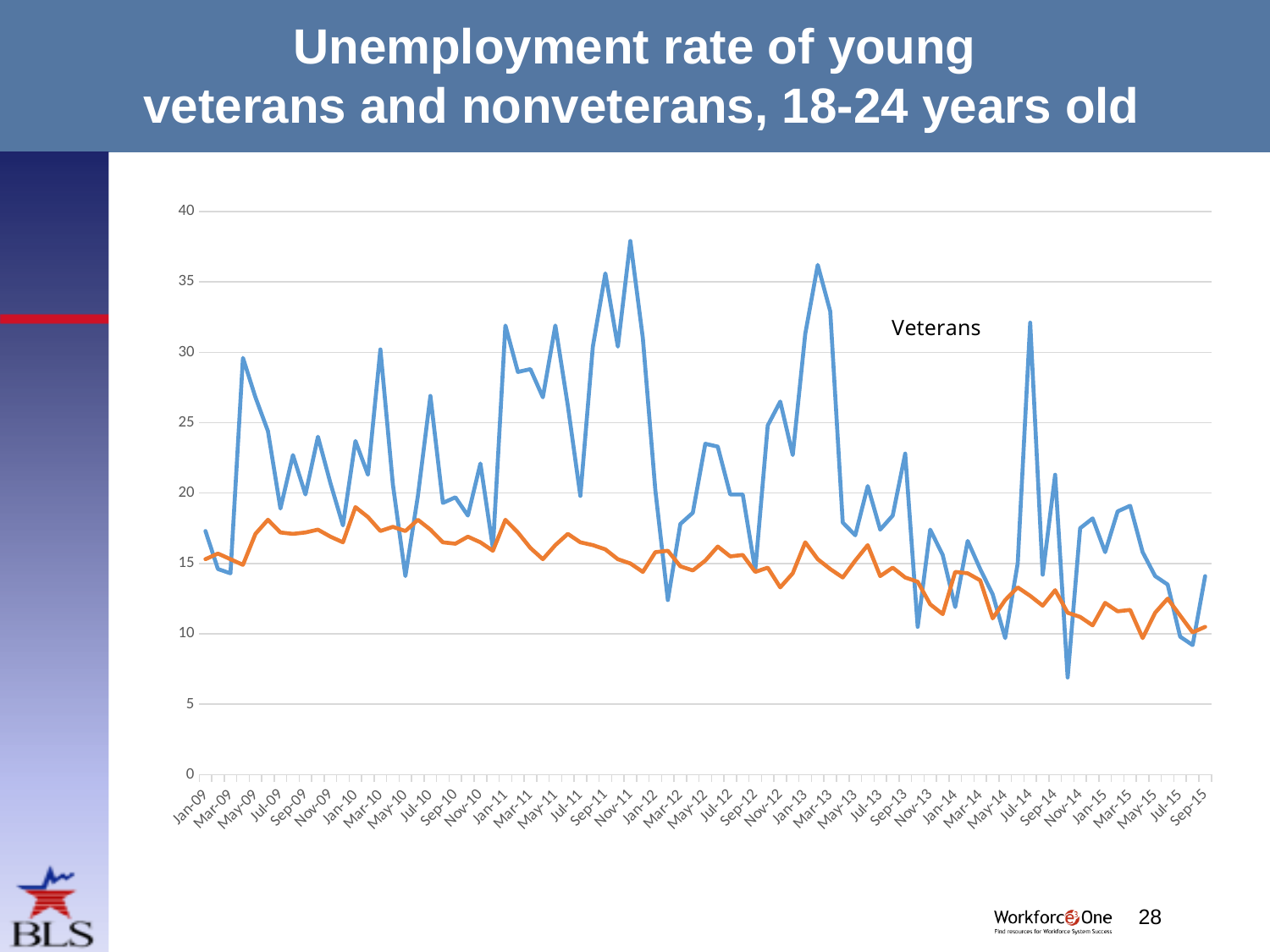
What is the highest value shown on the vertical axis? 40 Which series is labelled directly on the chart? Veterans Does the orange (nonveterans) line ever rise above 20? No Does the orange (nonveterans) line generally rise or fall from Jan-09 to Sep-15? fall Is the lowest value of the Veterans line (around Nov-14) greater or less than 10? less How many lines (series) are plotted on the chart? 2 What kind of chart is shown on the slide? line chart Around which month does the Veterans line reach its highest peak? Nov-11 Is the highest value of the Veterans line greater or less than 35? greater What is the title of the chart on the slide? Unemployment rate of young veterans and nonveterans, 18-24 years old Which series has the higher values for most of the period, Veterans or nonveterans? Veterans